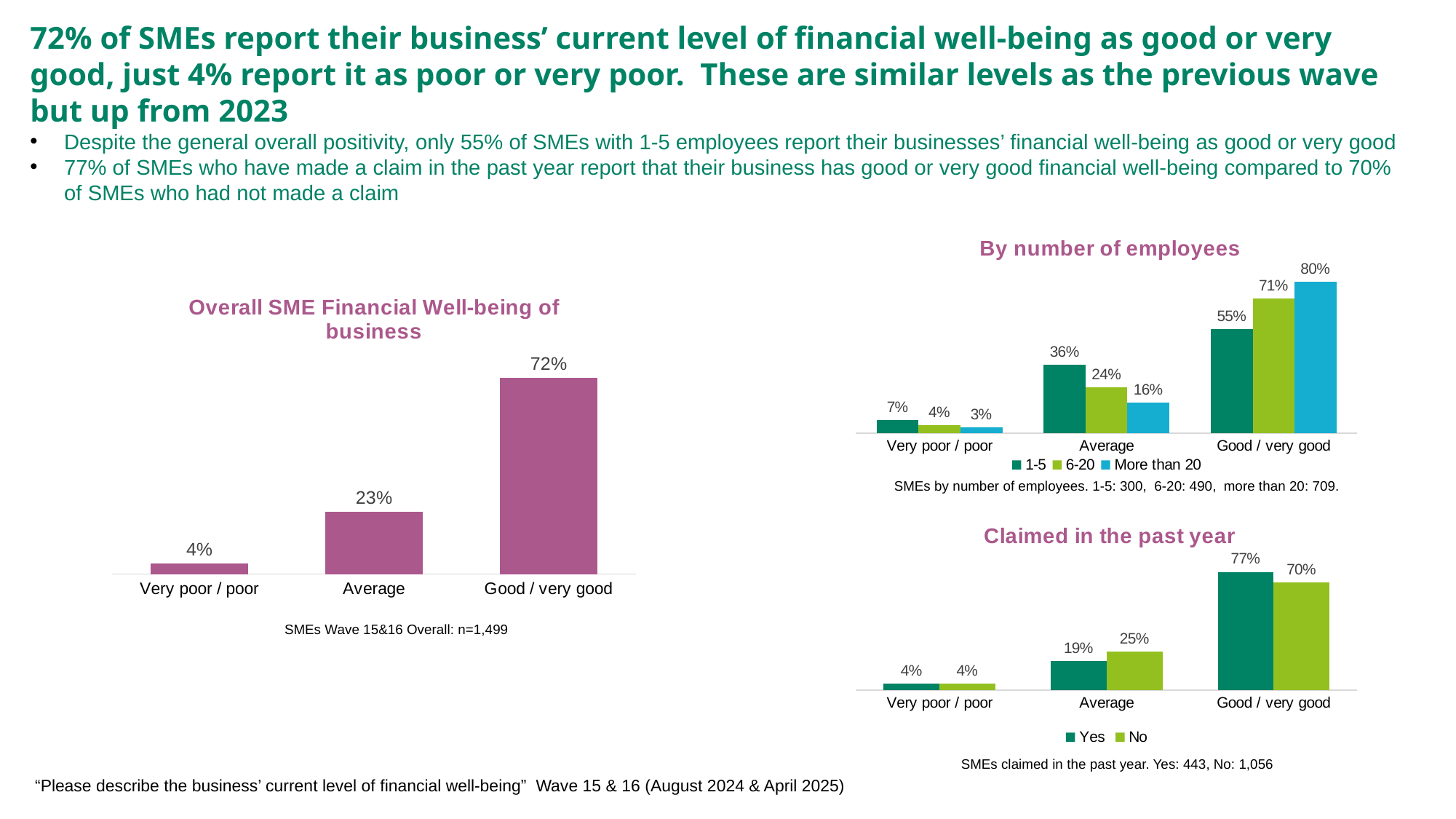
In the 'Overall SME Financial Well-being of business' chart, what is the value for Average? 23% In the 'By number of employees' chart, what is the value for 6-20 in the Average category? 24% In the 'Overall SME Financial Well-being of business' chart, what is the difference between Good / very good and Average? 49% What kind of chart is the 'Overall SME Financial Well-being of business' chart? Bar chart In the 'Claimed in the past year' chart, what is the difference between No and Yes for Average? 6% In the 'Claimed in the past year' chart, what is the value for No in the Average category? 25% How many categories are shown on the x axis of the 'Claimed in the past year' chart? 3 How many series does the legend of the 'By number of employees' chart list? 3 In the 'Overall SME Financial Well-being of business' chart, which category has the highest value? Good / very good In the 'Claimed in the past year' chart, which is larger for Good / very good, Yes or No? Yes In the 'By number of employees' chart, what is the difference between More than 20 and 1-5 for Good / very good? 25% In the 'By number of employees' chart, which employee group has the lowest value for Very poor / poor? More than 20